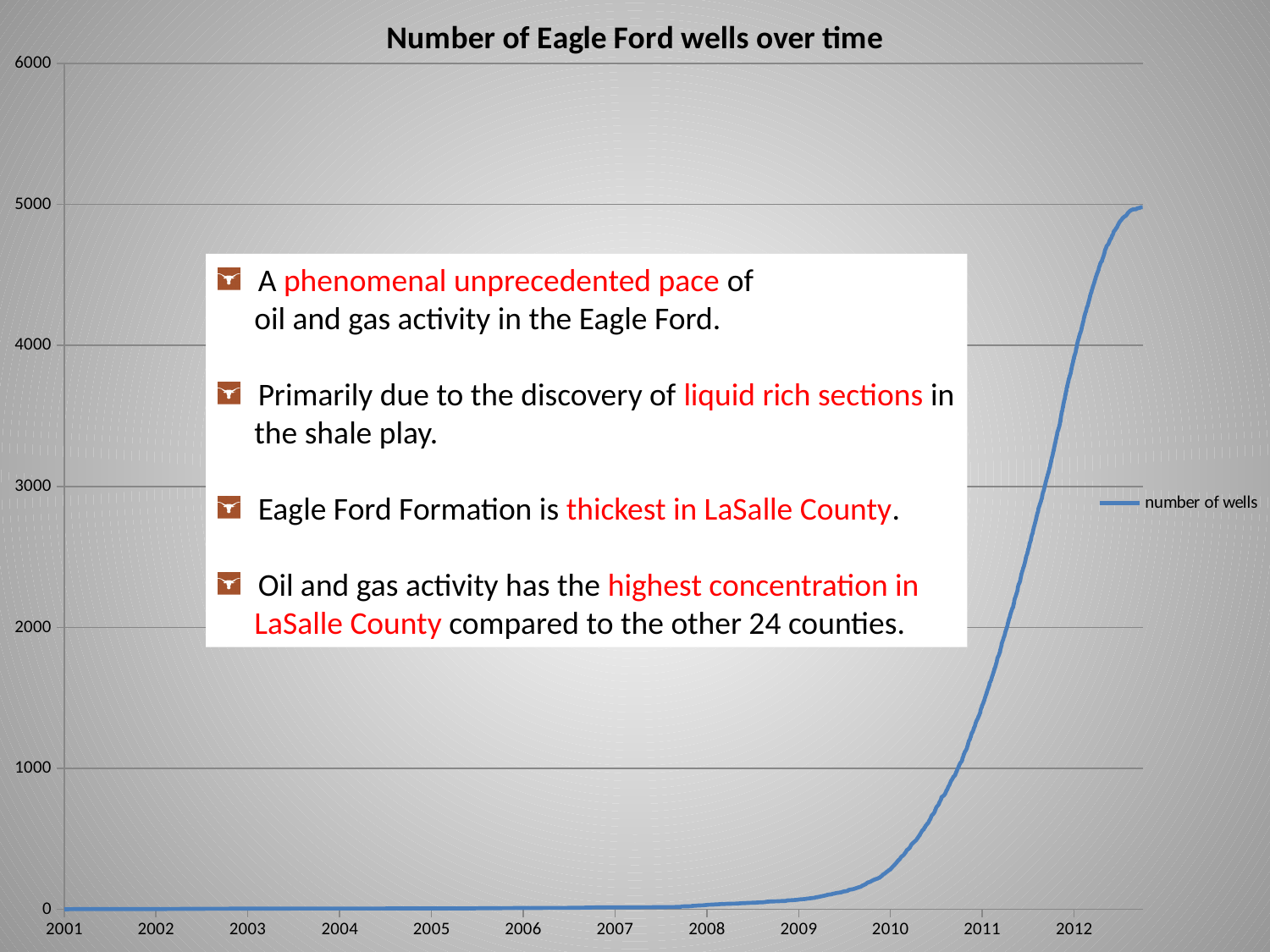
Does the number of wells rise or fall along the x axis from 2001 to 2012? rise How many series does the legend list? 1 Is the number of wells in 2012 larger or smaller than in 2009? larger Is the number of wells in 2010 greater or less than 1000? less What kind of chart is shown on the slide? line chart In which year labelled on the x axis is the number of wells highest? 2012 Is the highest value reached by the line greater or less than 6000? less How many year labels are shown on the x axis? 12 Is the number of wells in 2005 greater or less than 1000? less What is the name of the series shown in the legend? number of wells What is the title of the chart? Number of Eagle Ford wells over time